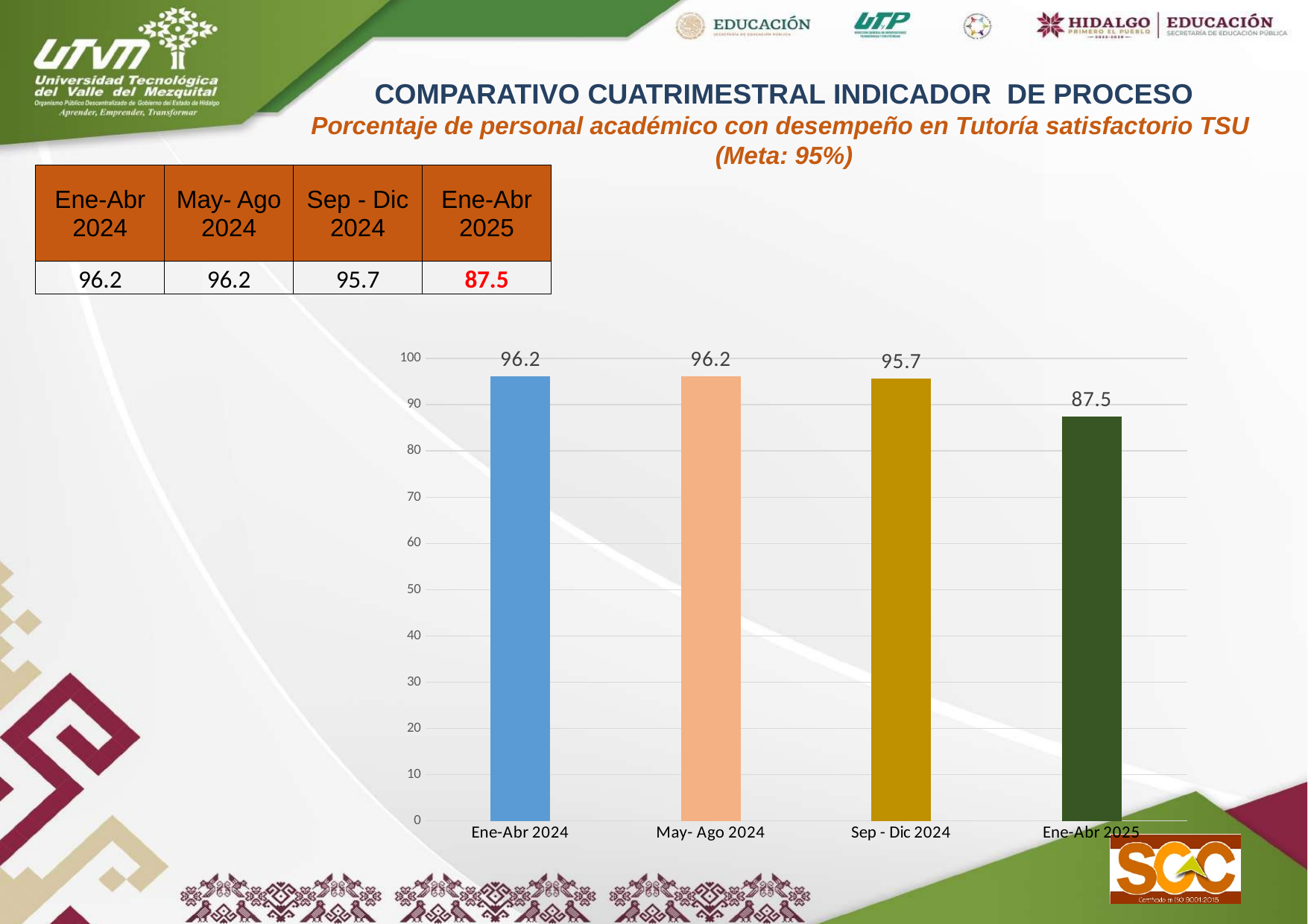
What is the difference between the values for May- Ago 2024 and Sep - Dic 2024? 0.5 Which is larger, the value for Sep - Dic 2024 or the value for Ene-Abr 2025? Sep - Dic 2024 Do the values rise or fall from Ene-Abr 2024 to Ene-Abr 2025? fall Which category has the lowest value? Ene-Abr 2025 What is the target (Meta) stated in the chart's subtitle? 95% What is the difference between the values for Sep - Dic 2024 and Ene-Abr 2025? 8.2 Is the value for Ene-Abr 2025 greater or less than 90? less What is the value for Ene-Abr 2024? 96.2 What is the value for Sep - Dic 2024? 95.7 What is the value for Ene-Abr 2025? 87.5 What kind of chart is shown on the slide? bar chart How many categories are shown on the x axis? 4